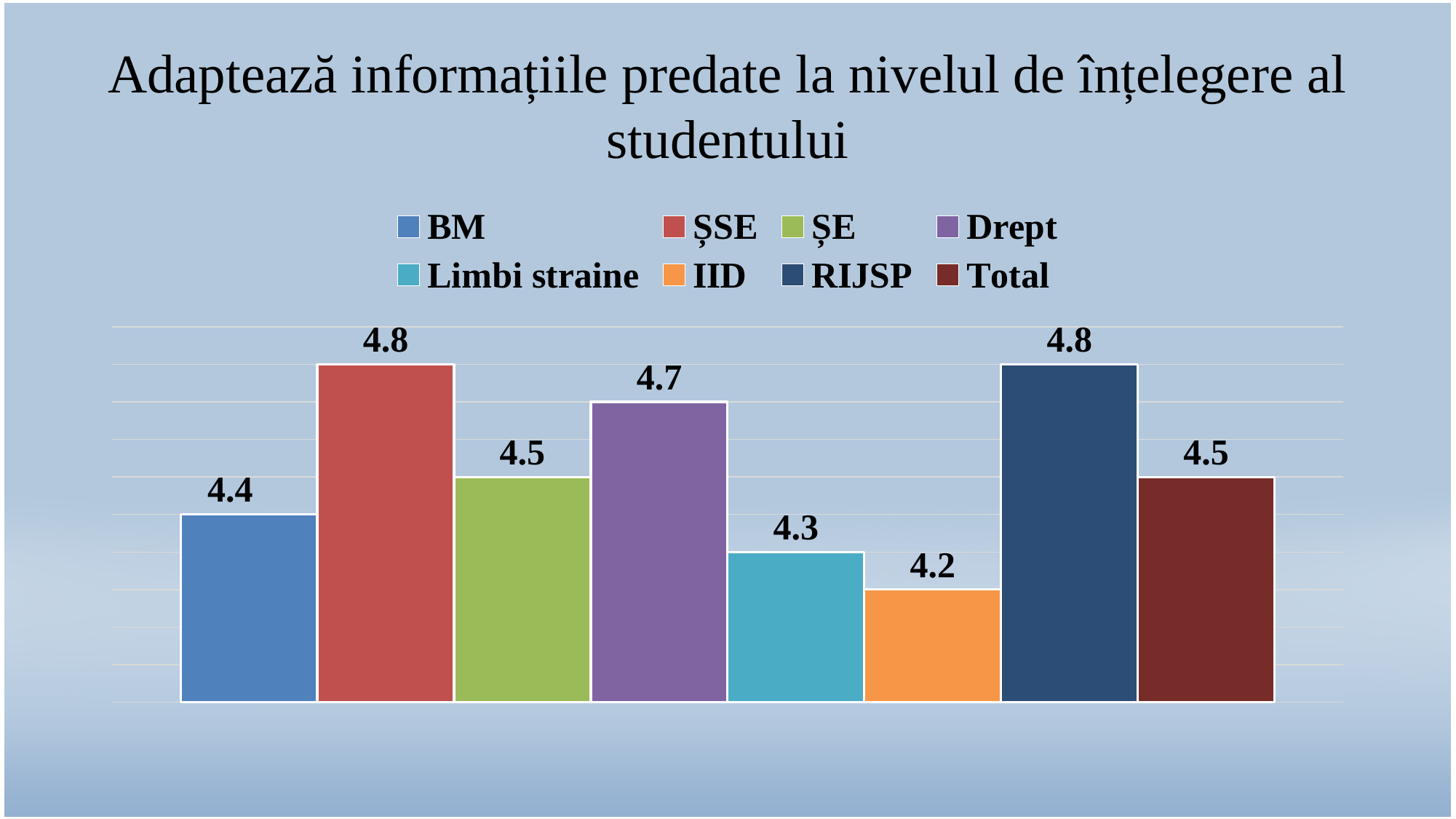
What is the value for Limbi straine? 4.3 How many series does the legend list? 8 Which is larger, the value for BM or the value for ȘE? ȘE What is the title of the chart? Adaptează informațiile predate la nivelul de înțelegere al studentului Which series has the lowest value? IID Which is larger, the value for Limbi straine or the value for IID? Limbi straine What is the value for Drept? 4.7 What is the difference between the values for ȘSE and IID? 0.6 What is the difference between the values for Drept and ȘE? 0.2 What kind of chart is shown on the slide? bar chart What is the value for BM? 4.4 What is the value for Total? 4.5